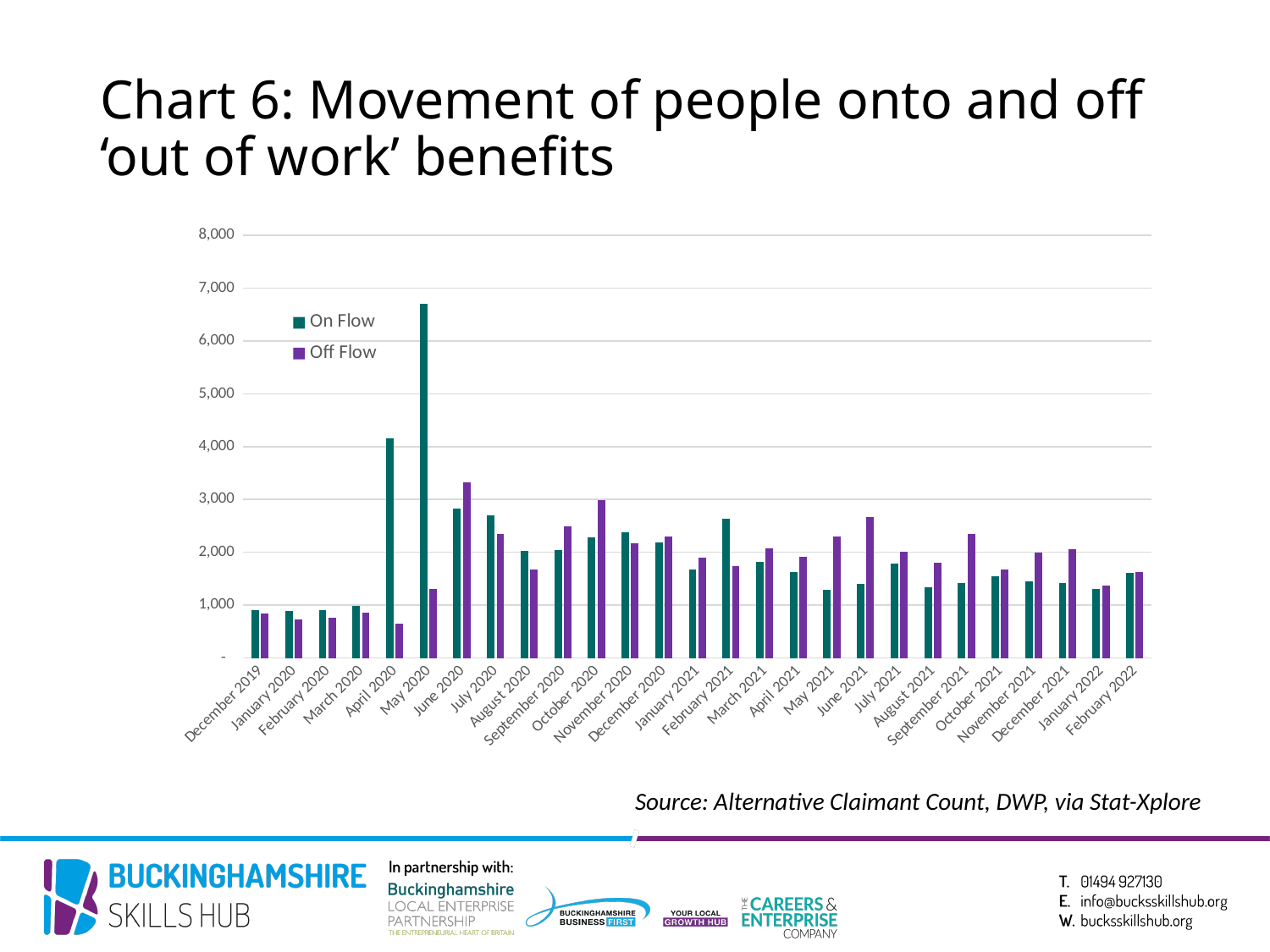
In June 2021, which is larger, On Flow or Off Flow? Off Flow Is the On Flow value for May 2020 greater or less than 6,000? greater In which month is the Off Flow value highest? June 2020 Is the Off Flow value for April 2020 greater or less than 1,000? less How many series does the legend list? 2 In May 2020, which is larger, On Flow or Off Flow? On Flow In which month is the Off Flow value lowest? April 2020 How many months are shown along the x axis? 27 Is the Off Flow value for June 2020 greater or less than 3,000? greater In which month is the On Flow value highest? May 2020 What kind of chart is shown on the slide? Bar chart